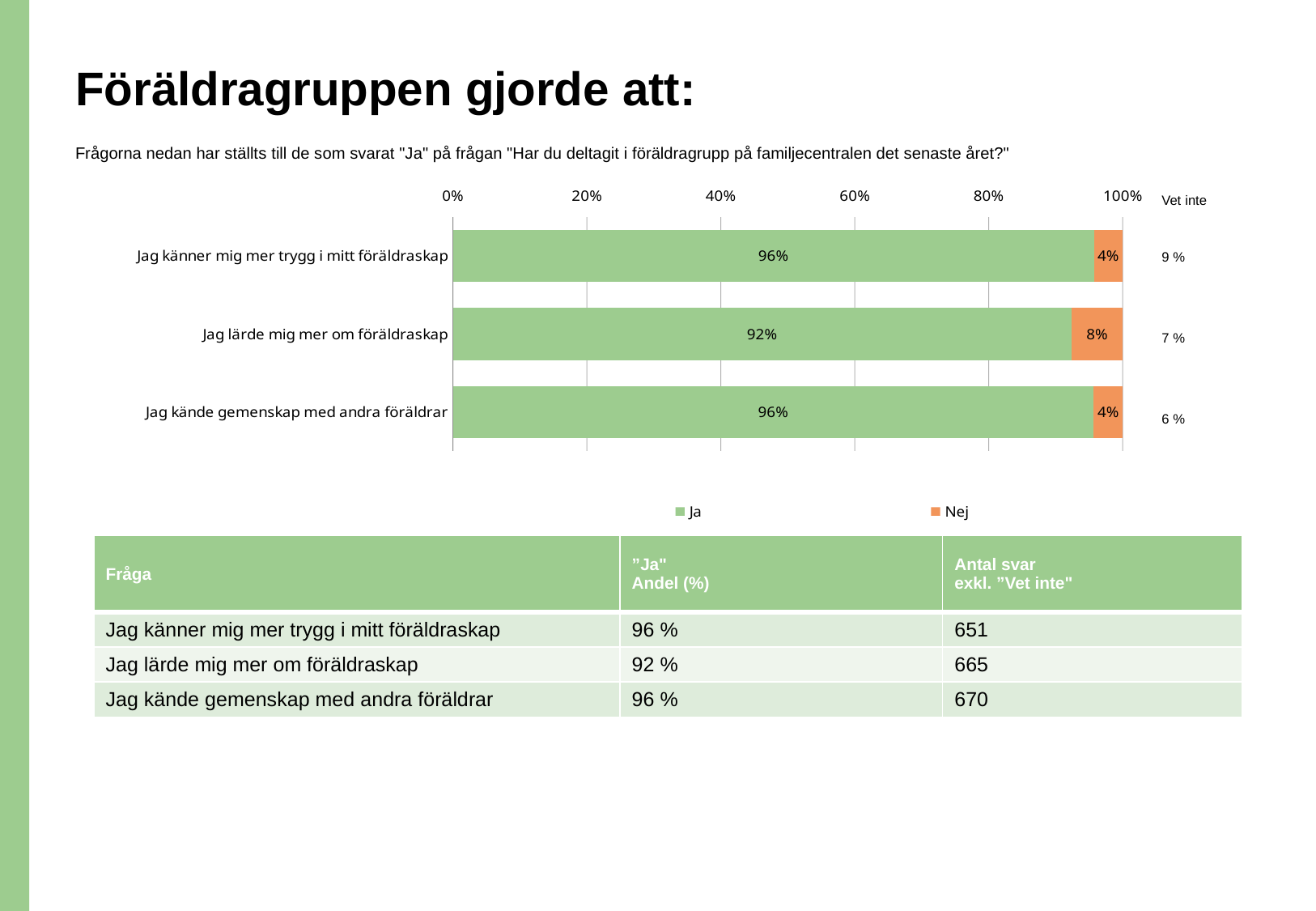
What is the difference between the "Ja" values for "Jag känner mig mer trygg i mitt föräldraskap" and "Jag lärde mig mer om föräldraskap"? 4% What is the "Nej" value for "Jag känner mig mer trygg i mitt föräldraskap"? 4% What is the "Nej" value for "Jag lärde mig mer om föräldraskap"? 8% What kind of chart is shown on the slide? Stacked bar chart How many series does the chart legend list? 2 Which series is shown in orange in the chart? Nej What is the "Ja" value for "Jag lärde mig mer om föräldraskap"? 92% What is the total of the stacked bar for "Jag kände gemenskap med andra föräldrar"? 100% Which is larger: the "Nej" value for "Jag lärde mig mer om föräldraskap" or the "Nej" value for "Jag kände gemenskap med andra föräldrar"? Jag lärde mig mer om föräldraskap Which category has the lowest "Ja" value? Jag lärde mig mer om föräldraskap Which category has the highest "Nej" value? Jag lärde mig mer om föräldraskap How many categories are plotted in the chart? 3